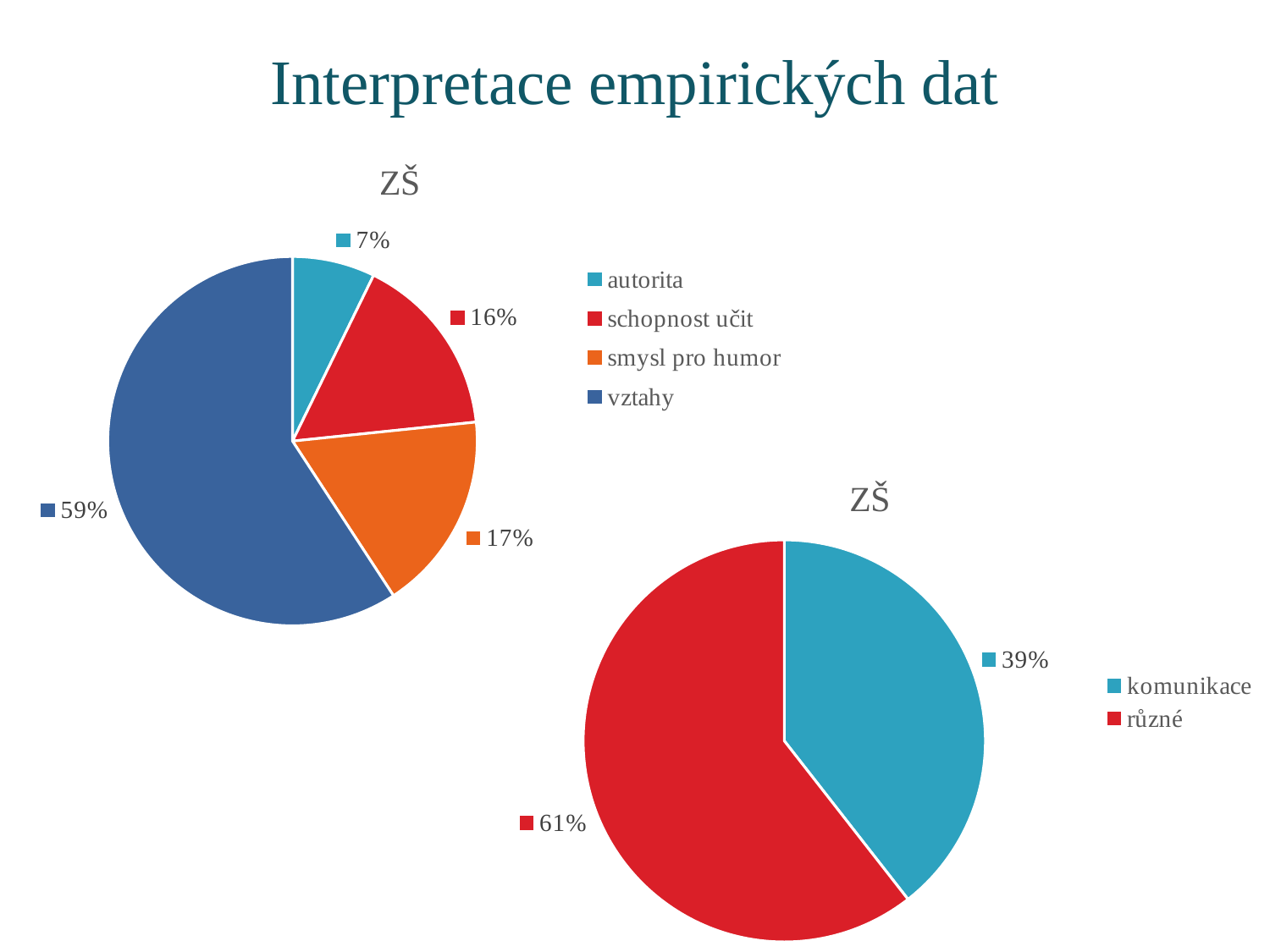
In the upper-left pie chart, what is the difference between the shares of vztahy and schopnost učit? 43% In the upper-left pie chart, which category has the largest share? vztahy In the upper-left pie chart, which category has the smallest share? autorita In the upper-left pie chart, what share does vztahy have? 59% What type of chart is the lower-right chart? pie chart In the upper-left pie chart, what share does smysl pro humor have? 17% In the upper-left pie chart, what share does autorita have? 7% In the lower-right pie chart, what share does různé have? 61% In the lower-right pie chart, how many entries does the legend list? 2 In the lower-right pie chart, which is larger, komunikace or různé? různé In the upper-left pie chart, how many categories are shown? 4 In the lower-right pie chart, what share does komunikace have? 39%